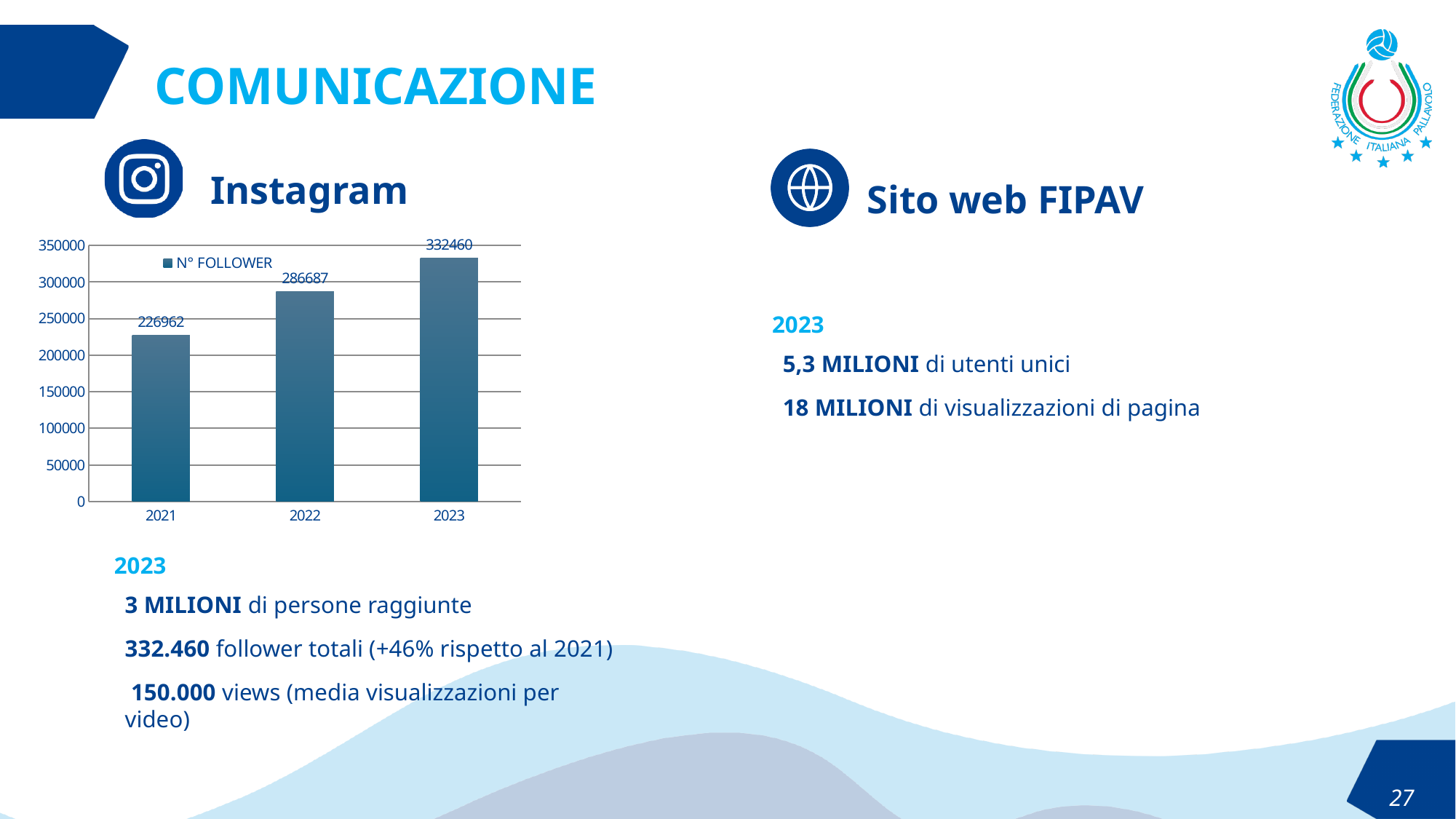
Which year has the lowest number of followers? 2021 What is the number of followers shown for 2021? 226962 What kind of chart is shown on the slide? bar chart Is the value for 2022 greater or less than 250000? greater What is the difference in followers between 2023 and 2021? 105498 What is the difference in followers between 2022 and 2021? 59725 Which year has more followers, 2022 or 2023? 2023 Do the follower numbers rise or fall from 2021 to 2023? rise What is the number of followers shown for 2023? 332460 What is the number of followers shown for 2022? 286687 How many years are shown on the x axis of the chart? 3 Which year has the highest number of followers? 2023